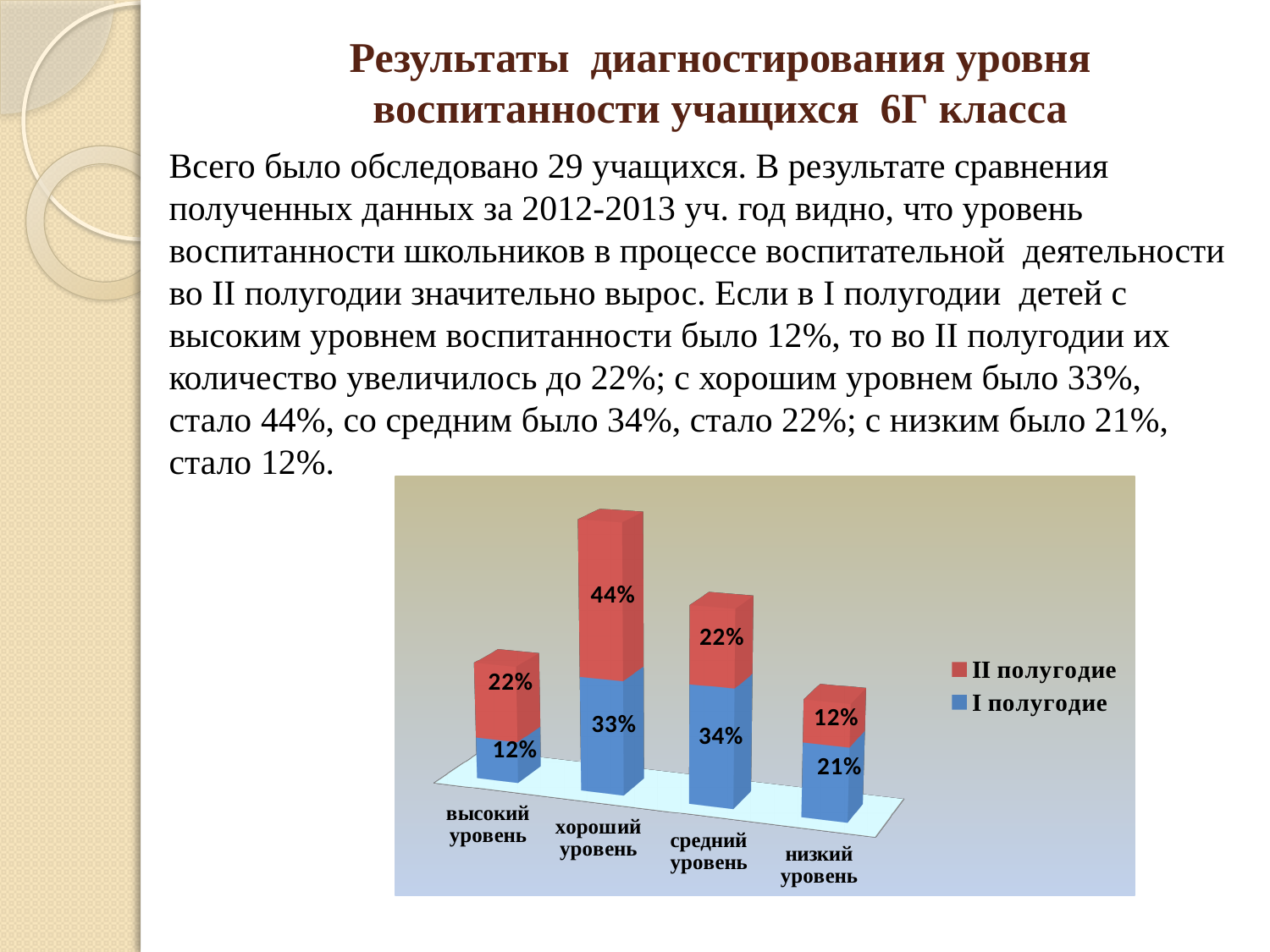
What is the value for «II полугодие» in the «высокий уровень» category? 22% How many series does the legend list? 2 Which category has the highest value for «II полугодие»? хороший уровень Which is larger in the «средний уровень» category: the «I полугодие» value or the «II полугодие» value? I полугодие Which category has the lowest value for «I полугодие»? высокий уровень What is the value for «II полугодие» in the «низкий уровень» category? 12% How many categories are shown on the x axis? 4 What is the total of the stacked bar for «хороший уровень»? 77% What kind of chart is shown on the slide? Stacked bar chart What is the value for «I полугодие» in the «хороший уровень» category? 33% What is the difference between the «II полугодие» and «I полугодие» values in the «высокий уровень» category? 10% Which colour represents «II полугодие» in the chart? Red